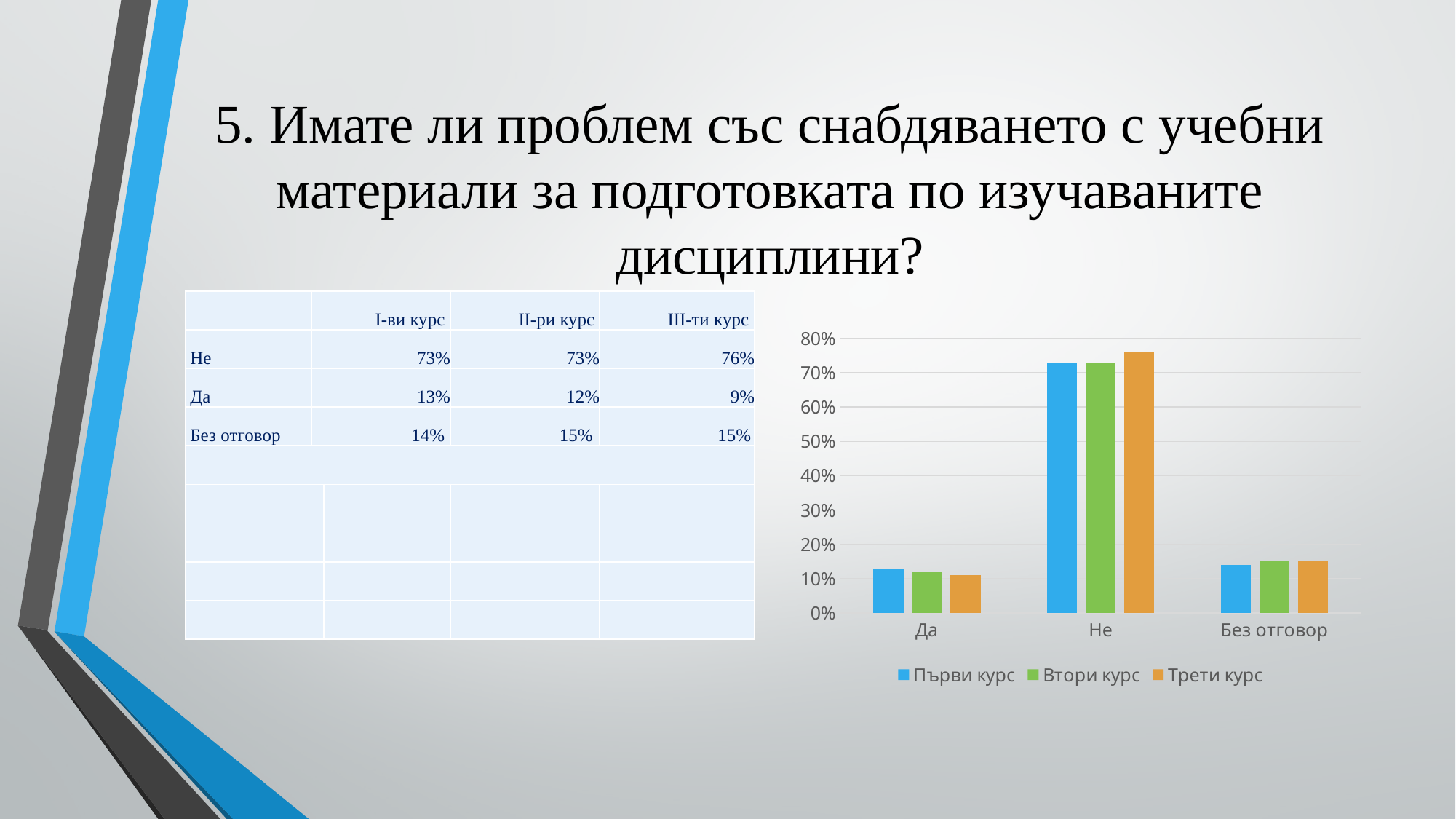
Which category has the highest value for Първи курс? Не Is the value for "Не" for Втори курс greater or less than 70%? greater What is the value for "Да" for the first-year students (I-ви курс / Първи курс)? 13% Is the value for "Без отговор" for Първи курс greater or less than 20%? less How many series does the chart legend list? 3 What colour represents Трети курс in the chart legend? orange For the category "Да", which is larger: the value for Първи курс or for Трети курс? Първи курс What kind of chart is shown on the slide? bar chart Which category has the lowest value for Трети курс? Да How many categories are shown on the x axis of the chart? 3 What is the value for "Не" for the third-year students (III-ти курс / Трети курс)? 76%